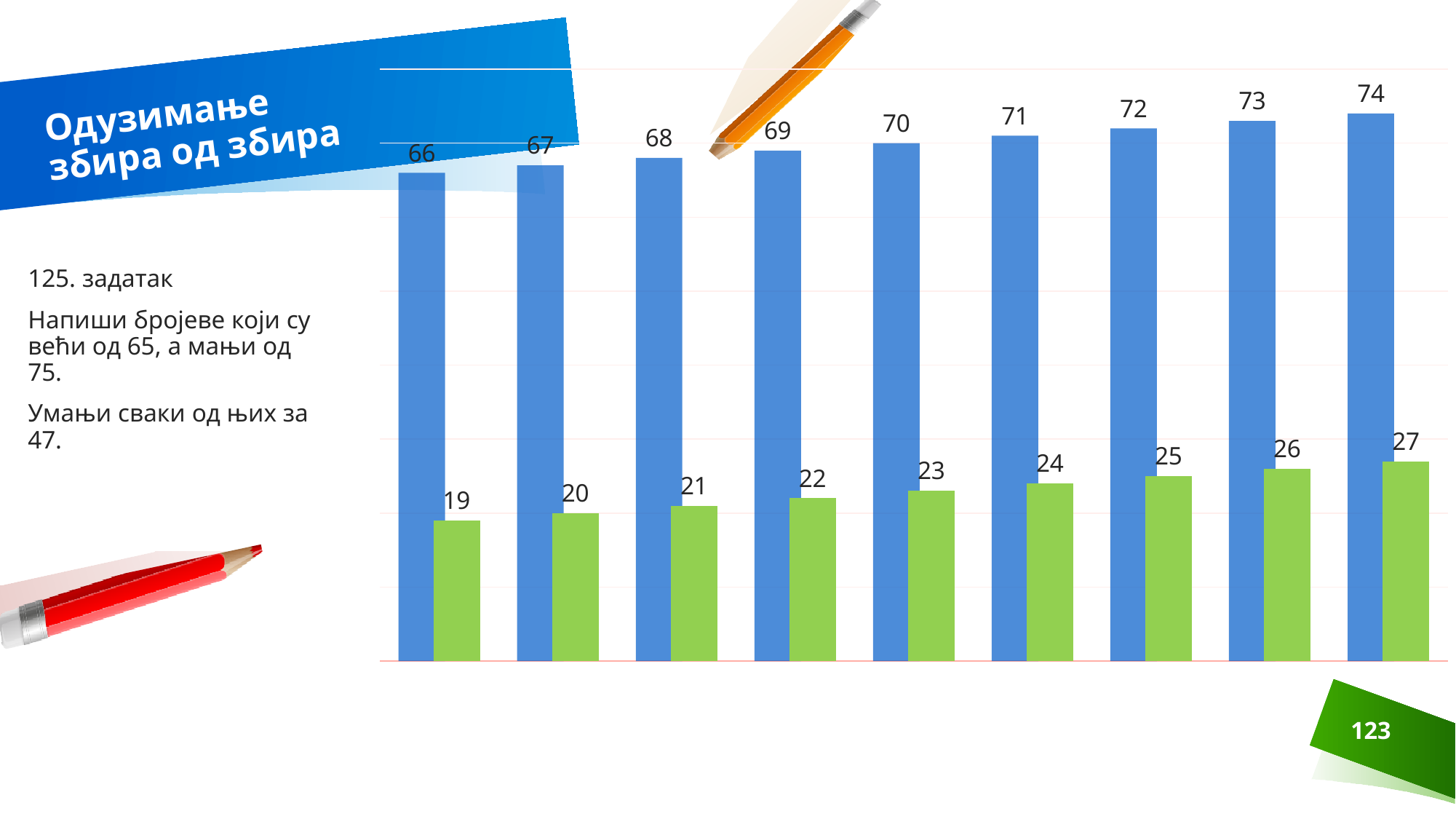
What is the value of the leftmost blue bar? 66 What is the highest value among the blue bars? 74 What kind of chart is shown on the slide? bar chart What is the difference between the rightmost blue bar (74) and the leftmost blue bar (66)? 8 What is the value of the green bar in the fifth group from the left? 23 What is the difference between the blue bar and the green bar in the leftmost group? 47 What is the value of the rightmost green bar? 27 Which is larger, the blue bar in the third group (68) or the green bar in the ninth group (27)? the blue bar in the third group (68) What is the lowest value among the green bars? 19 Do the blue bar values rise or fall from left to right? rise How many groups of bars does the chart contain? 9 What colour are the taller bars in each group? blue